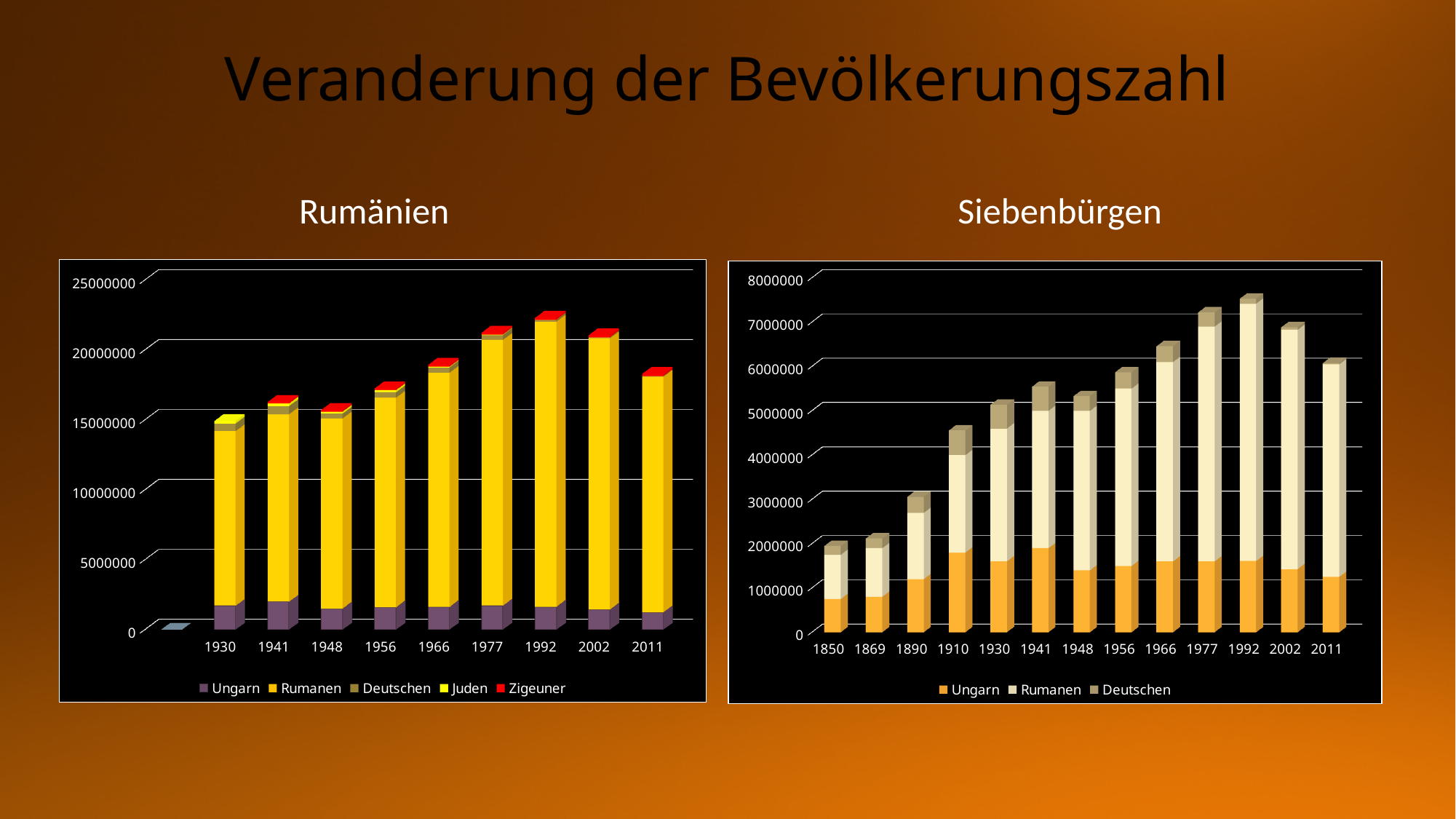
In the Siebenbürgen chart, do the totals rise or fall from 1850 to 1992? rise What type of chart is the Rumänien chart on the left? Stacked bar chart In the Siebenbürgen chart, which year has the tallest stacked bar? 1992 How many years are shown on the x axis of the Siebenbürgen chart? 13 How many series does the legend of the Siebenbürgen chart list? 3 How many years are shown on the x axis of the Rumänien chart? 9 In the Siebenbürgen chart, is the total for 1910 greater or less than 4000000? greater In the Rumänien chart, is the total for 2011 greater or less than 20000000? less In the Siebenbürgen chart, which year has the larger total, 1890 or 1910? 1910 How many series does the legend of the Rumänien chart list? 5 In the Rumänien chart, which year has the tallest stacked bar? 1992 In the Siebenbürgen chart, is the total for 1850 greater or less than 3000000? less